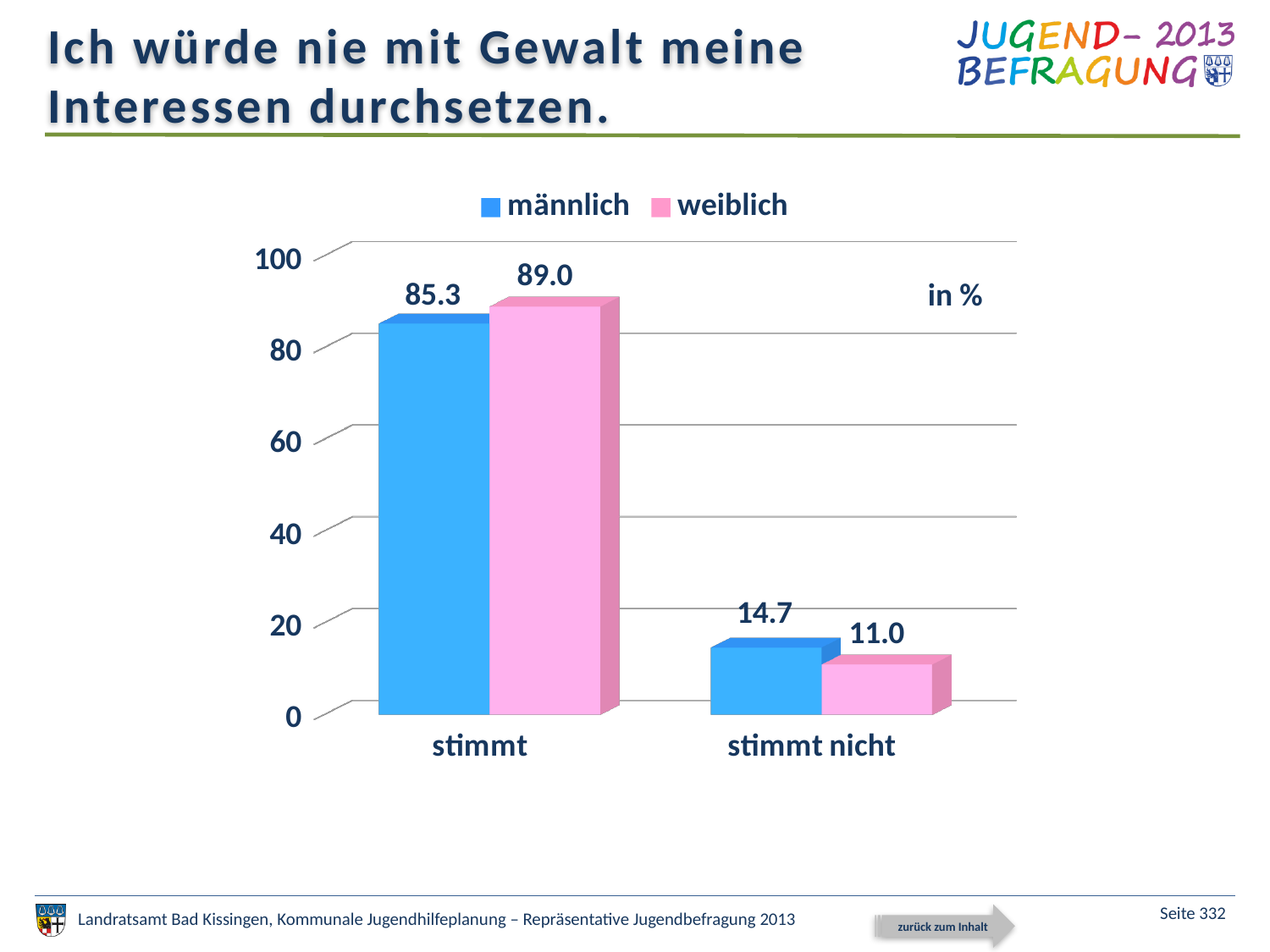
What is the difference between the männlich and weiblich values in the stimmt nicht category? 3.7 What is the difference between the weiblich and männlich values in the stimmt category? 3.7 Which series has the higher value in the stimmt category? weiblich How many categories are shown on the x axis? 2 What is the value for weiblich in the stimmt nicht category? 11.0 What is the value for männlich in the stimmt category? 85.3 What is the value for männlich in the stimmt nicht category? 14.7 How many series does the legend list? 2 Which series has the higher value in the stimmt nicht category? männlich What is the value for weiblich in the stimmt category? 89.0 What kind of chart is shown on the slide? bar chart What colour represents the weiblich series? pink